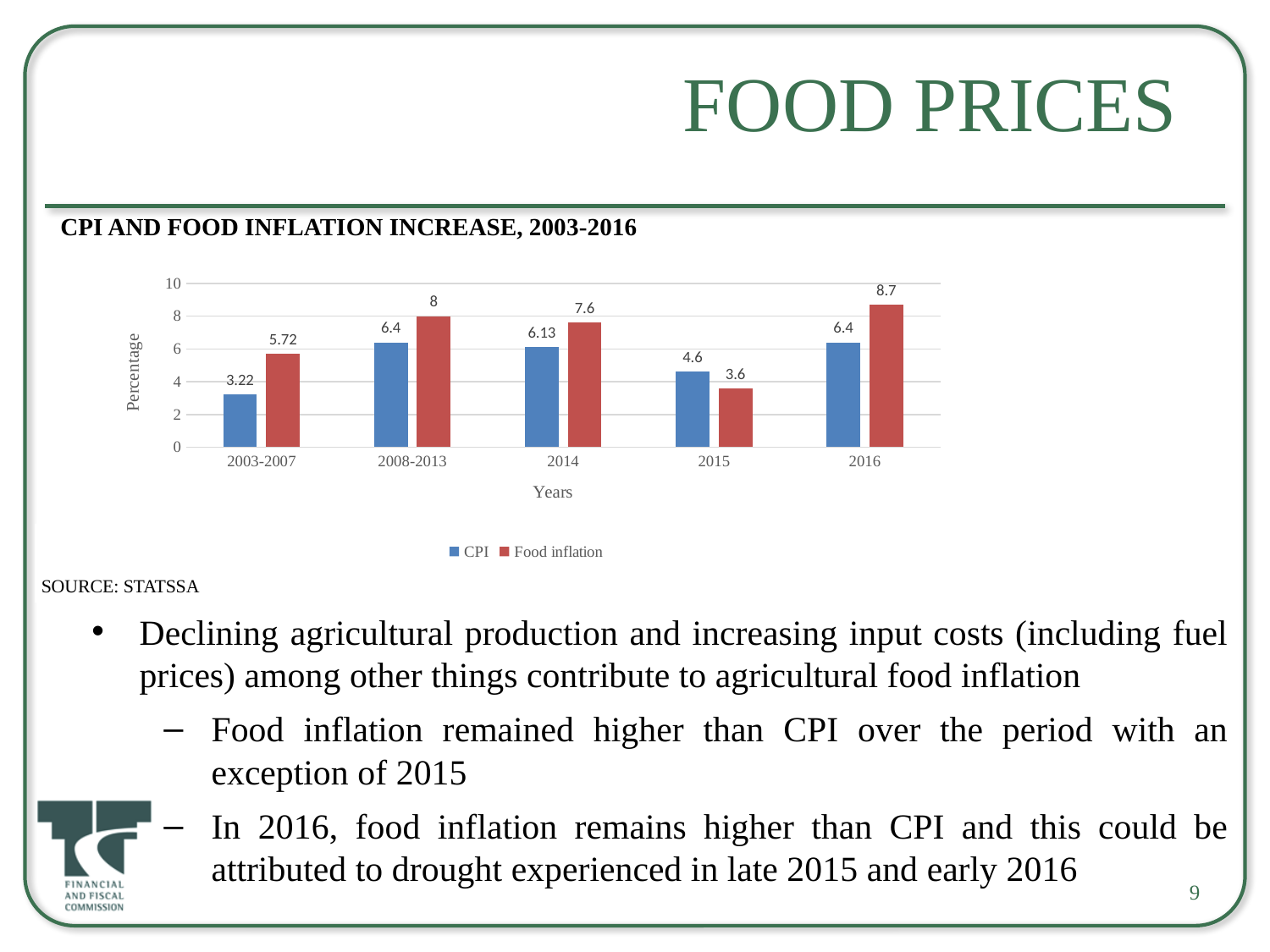
What is the Food inflation value for 2016? 8.7 What is the difference between Food inflation and CPI in 2003-2007? 2.5 How many categories are shown on the x axis? 5 What is the Food inflation value for 2015? 3.6 What is the CPI value for 2003-2007? 3.22 What is the title of the chart? CPI AND FOOD INFLATION INCREASE, 2003-2016 Which is larger in 2015, CPI or Food inflation? CPI Which category has the lowest CPI value? 2003-2007 What kind of chart is shown on the slide? Bar chart What is the label of the y axis? Percentage How many series does the legend list? 2 Which category has the highest Food inflation value? 2016